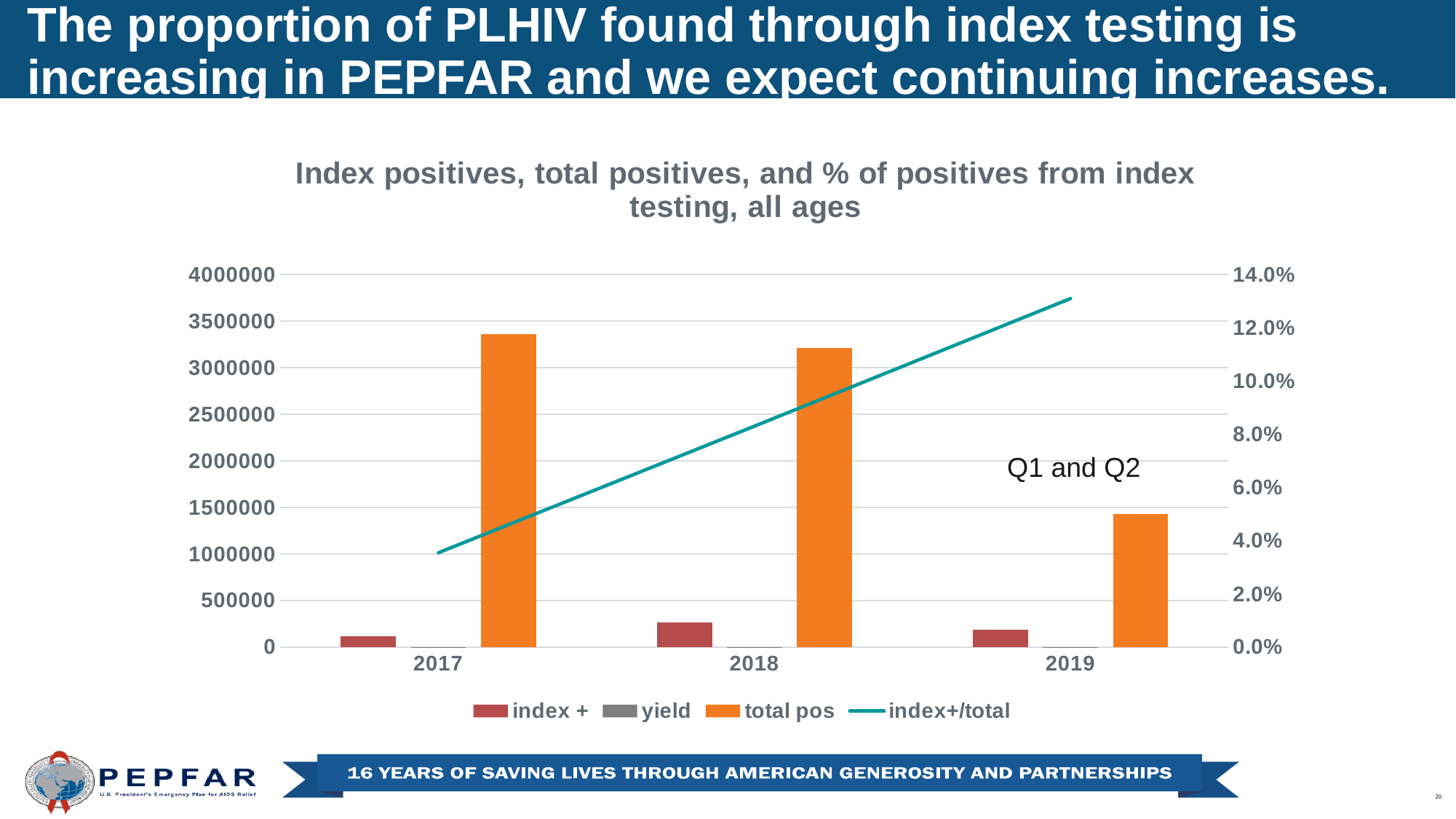
Which year has the highest index + bar? 2018 How many series does the legend list? 4 Is the total pos value for 2017 greater or less than 3000000? greater Is the total pos value for 2019 greater or less than 2000000? less What kind of chart is shown on the slide? Combined bar and line chart Does the index+/total line rise or fall from 2017 to 2019? Rises Which year has the lowest index + bar? 2017 Which year has the highest total pos bar? 2017 Is the index+/total value for 2019 greater or less than 12.0%? greater How many years are shown on the x axis? 3 What annotation is written above the 2019 bars? Q1 and Q2 Which year has the lowest total pos bar? 2019